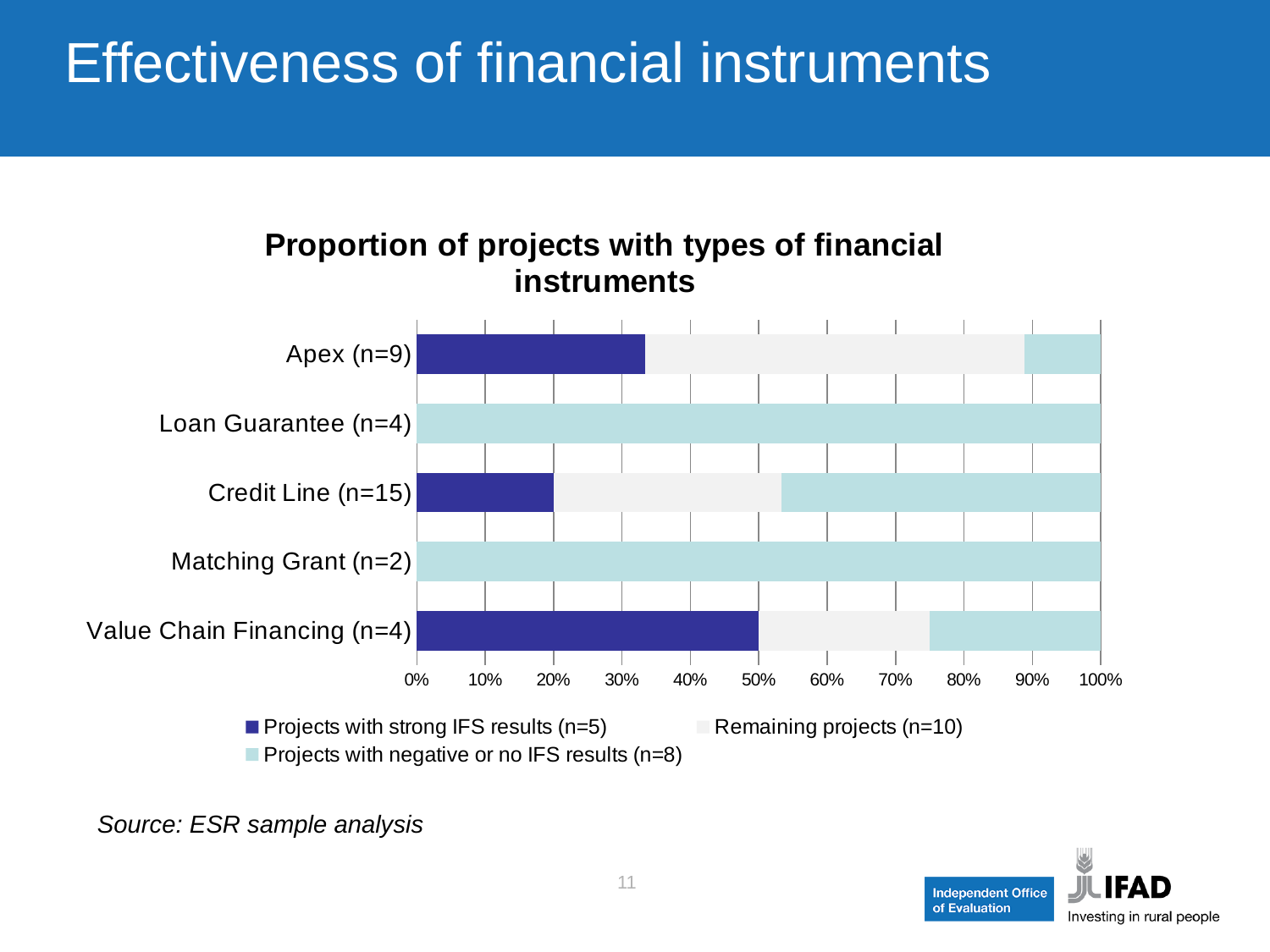
What kind of chart is shown on the slide? Stacked bar chart Which financial instrument has the highest proportion of projects with strong IFS results? Value Chain Financing (n=4) What proportion of Loan Guarantee (n=4) projects had negative or no IFS results? 100% Which has a larger proportion of projects with strong IFS results, Apex (n=9) or Credit Line (n=15)? Apex (n=9) What is the title of the chart? Proportion of projects with types of financial instruments How many financial instrument categories are shown on the chart? 5 Which category has the largest sample size (n) according to the axis labels? Credit Line (n=15) What proportion of Credit Line (n=15) projects had strong IFS results? 20% Is the proportion of Apex (n=9) projects with negative or no IFS results greater or less than 20%? less What proportion of Value Chain Financing (n=4) projects had strong IFS results? 50% Is the proportion of Apex (n=9) projects with strong IFS results greater or less than 30%? greater How many series does the legend list? 3